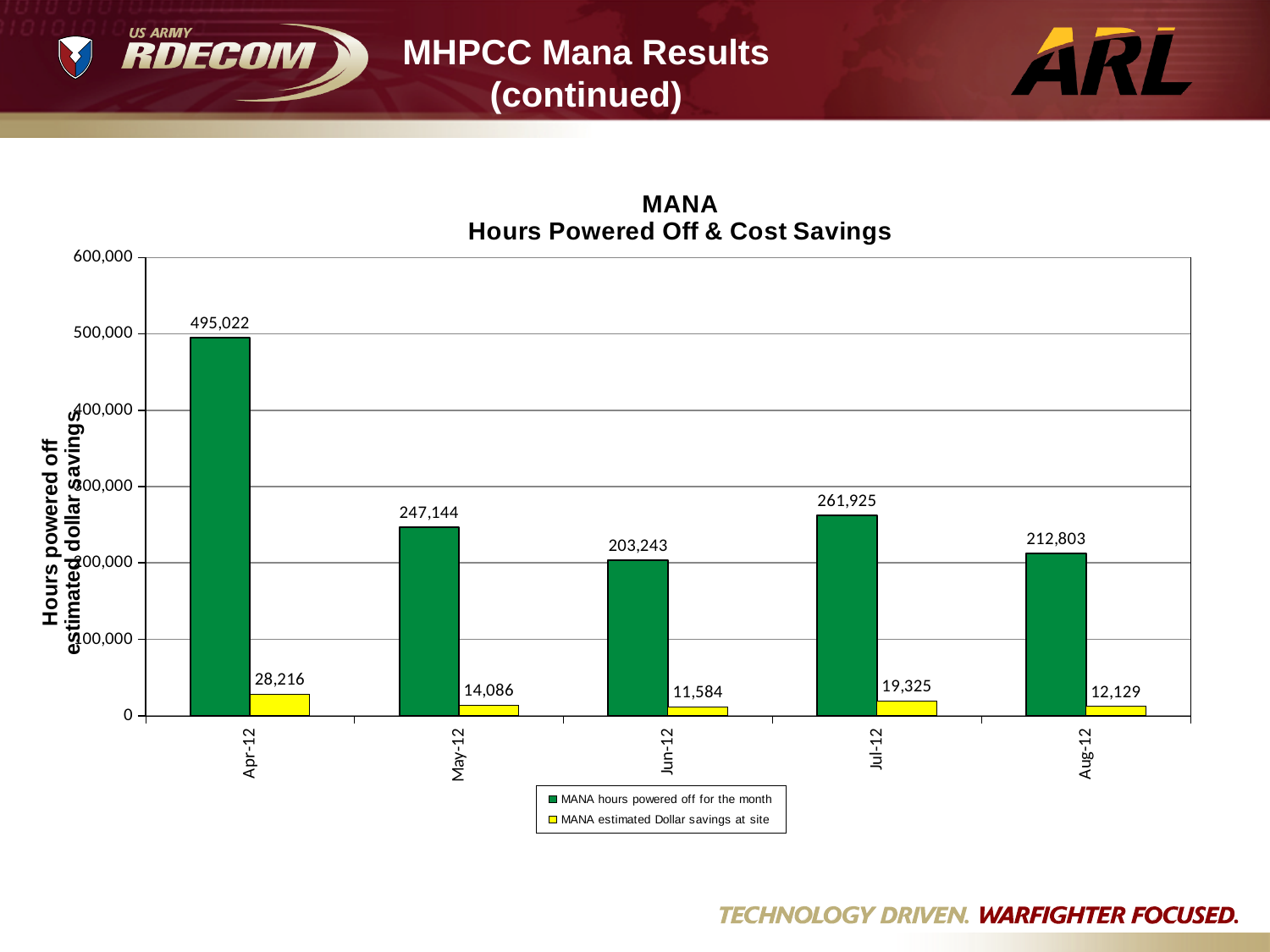
What is the difference between the MANA hours powered off for Apr-12 and May-12? 247,878 What type of chart is shown on the slide? Bar chart Which month has the lowest MANA estimated Dollar savings at site? Jun-12 What is the value of MANA hours powered off for the month for Jun-12? 203,243 Which month has the highest MANA hours powered off for the month? Apr-12 What is the difference between the MANA estimated Dollar savings at site for Jul-12 and Jun-12? 7,741 What is the MANA estimated Dollar savings at site for Jul-12? 19,325 How many months are shown on the x axis of the chart? 5 Which is larger, the MANA hours powered off for Jul-12 or for Aug-12? Jul-12 What is the value of MANA hours powered off for the month for Apr-12? 495,022 How many series does the chart legend list? 2 Is the value of MANA hours powered off for May-12 greater or less than 300,000? less